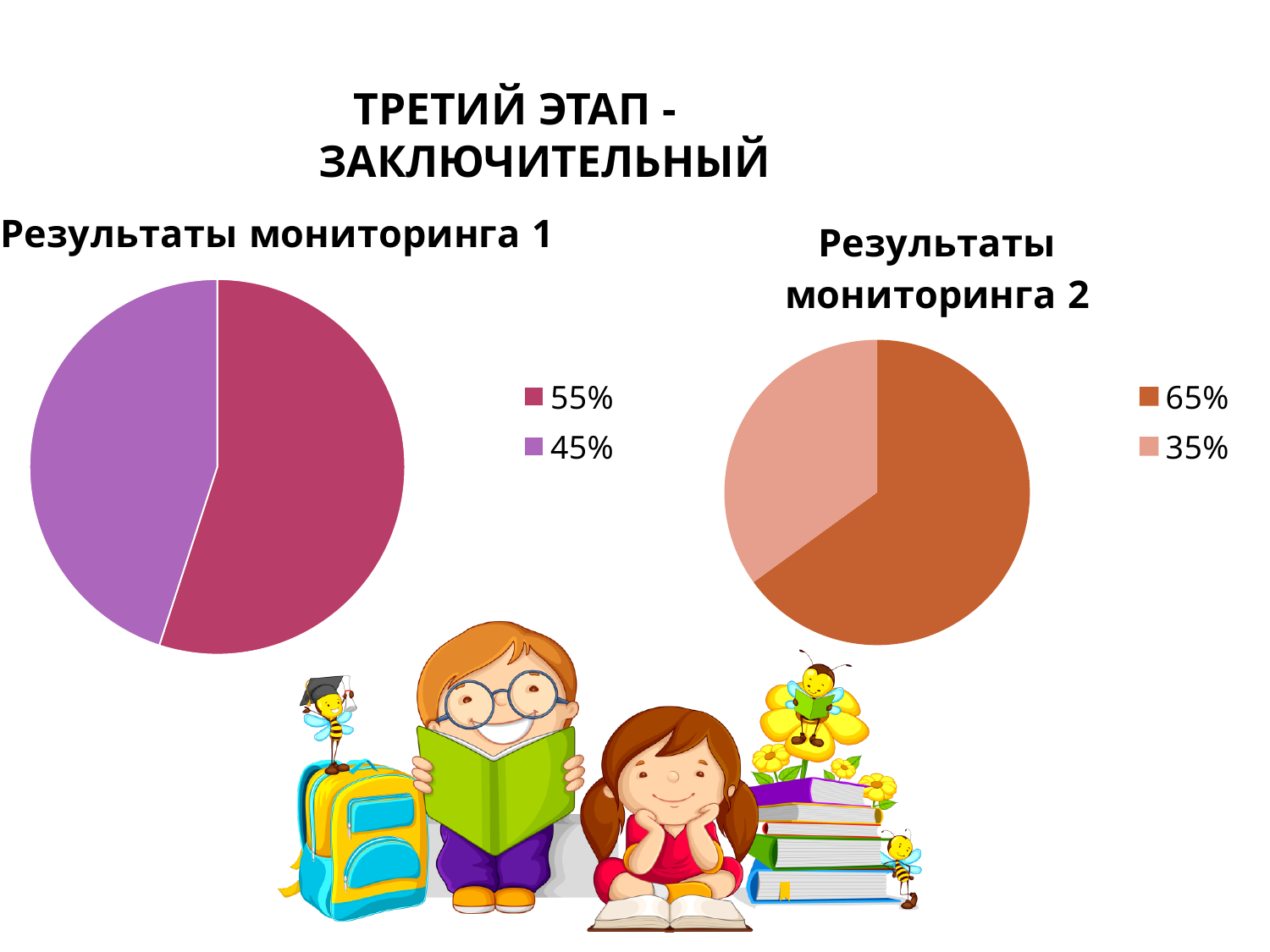
In the chart "Результаты мониторинга 1", what is the difference in percentage points between the two slices? 10 In the chart "Результаты мониторинга 1", what colour is the 45% slice? purple What kind of chart is "Результаты мониторинга 2"? pie chart What kind of chart is "Результаты мониторинга 1"? pie chart In the chart "Результаты мониторинга 2", how many entries does the legend list? 2 In the chart "Результаты мониторинга 2", what is the difference in percentage points between the two slices? 30 In the chart "Результаты мониторинга 2", what share of the pie does the smallest slice represent? 35% In the chart "Результаты мониторинга 1", what share of the pie does the smallest slice represent? 45% In the chart "Результаты мониторинга 1", how many slices does the pie have? 2 In the chart "Результаты мониторинга 1", what share of the pie does the largest slice represent? 55% In the chart "Результаты мониторинга 2", what share of the pie does the largest slice represent? 65% Which chart has the larger biggest slice: "Результаты мониторинга 1" or "Результаты мониторинга 2"? Результаты мониторинга 2